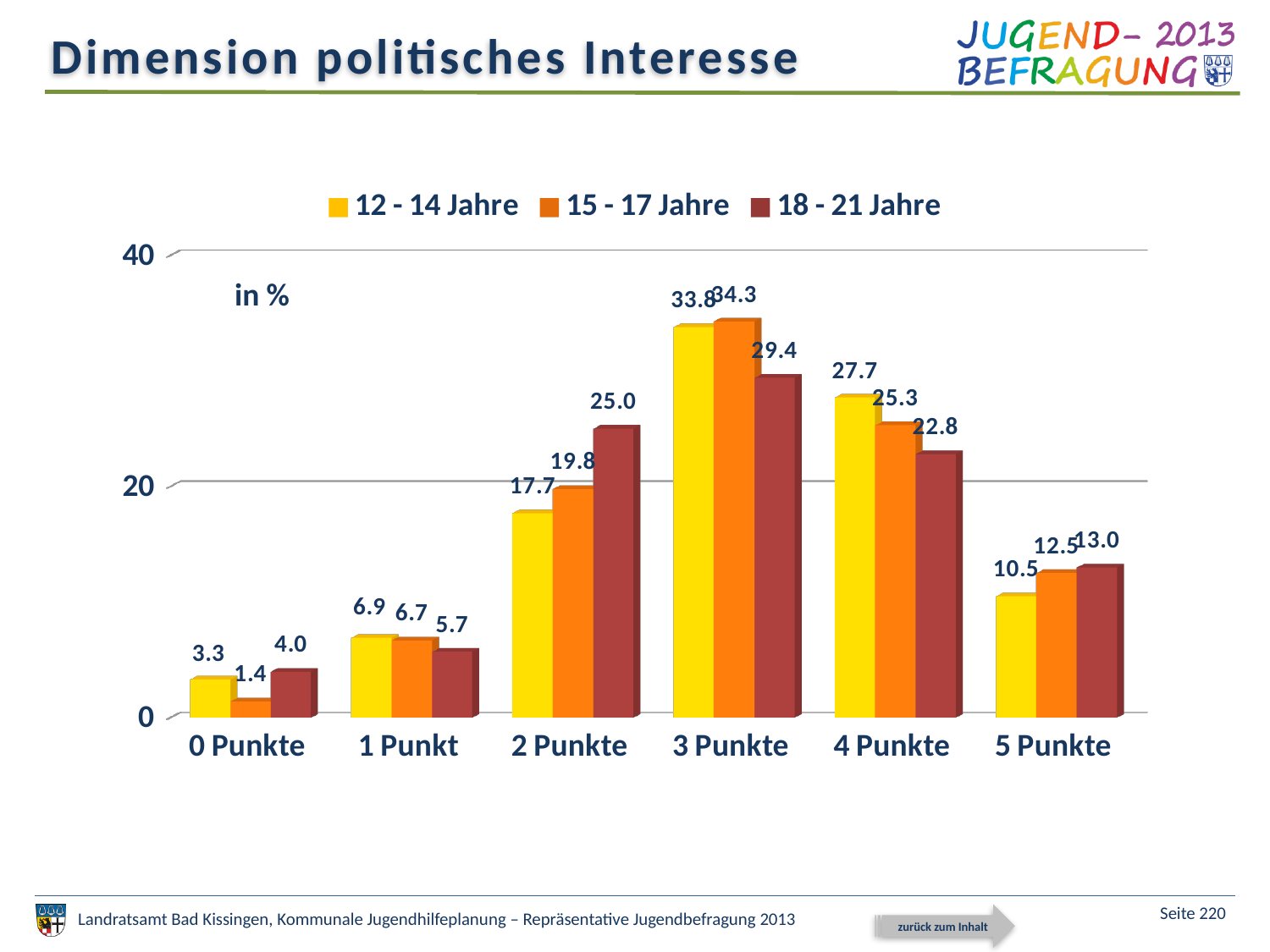
How many categories are shown on the x axis? 6 What is the value for 12 - 14 Jahre at 4 Punkte? 27.7 Which category has the highest value for the 15 - 17 Jahre series? 3 Punkte What is the difference between the 18 - 21 Jahre and 12 - 14 Jahre values at 2 Punkte? 7.3 Which category has the lowest value for the 18 - 21 Jahre series? 0 Punkte What is the value for 15 - 17 Jahre at 0 Punkte? 1.4 At 4 Punkte, which series has the larger value: 12 - 14 Jahre or 18 - 21 Jahre? 12 - 14 Jahre Is the value for 18 - 21 Jahre at 3 Punkte greater or less than 20? greater How many series does the legend list? 3 What unit is indicated by the label inside the plot area? in % What kind of chart is shown on the slide? bar chart What is the value for 18 - 21 Jahre at 2 Punkte? 25.0